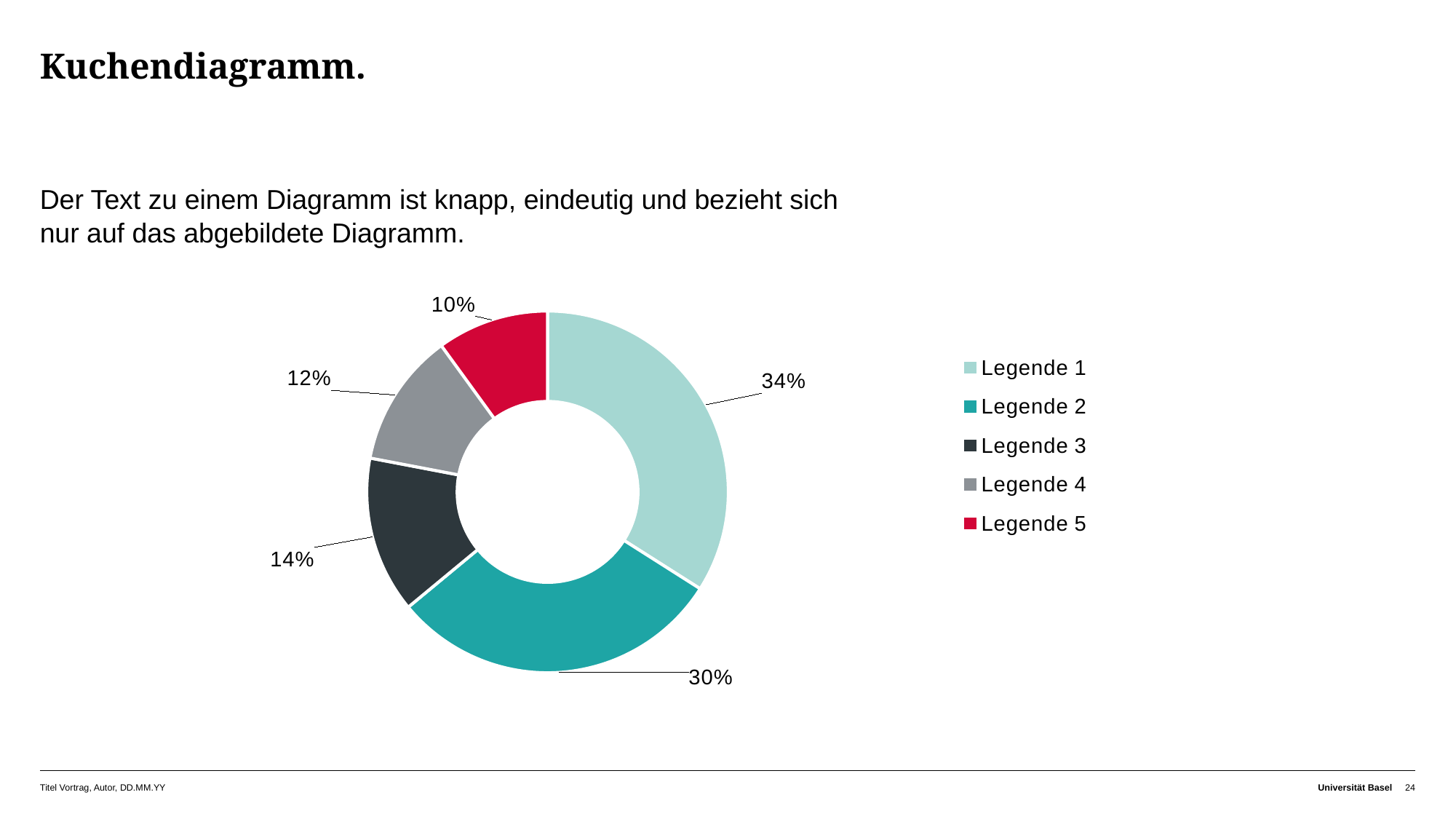
Which category has the largest slice? Legende 1 What share of the pie does Legende 2 have? 30% What share of the pie does Legende 3 have? 14% What share of the pie does Legende 5 have? 10% What kind of chart is shown on the slide? Pie chart (doughnut) Which is larger, the share of Legende 3 or the share of Legende 4? Legende 3 What is the difference between the shares of Legende 1 and Legende 2? 4% What colour is the slice for Legende 5? Red How many slices does the pie chart have? 5 Which category has the smallest slice? Legende 5